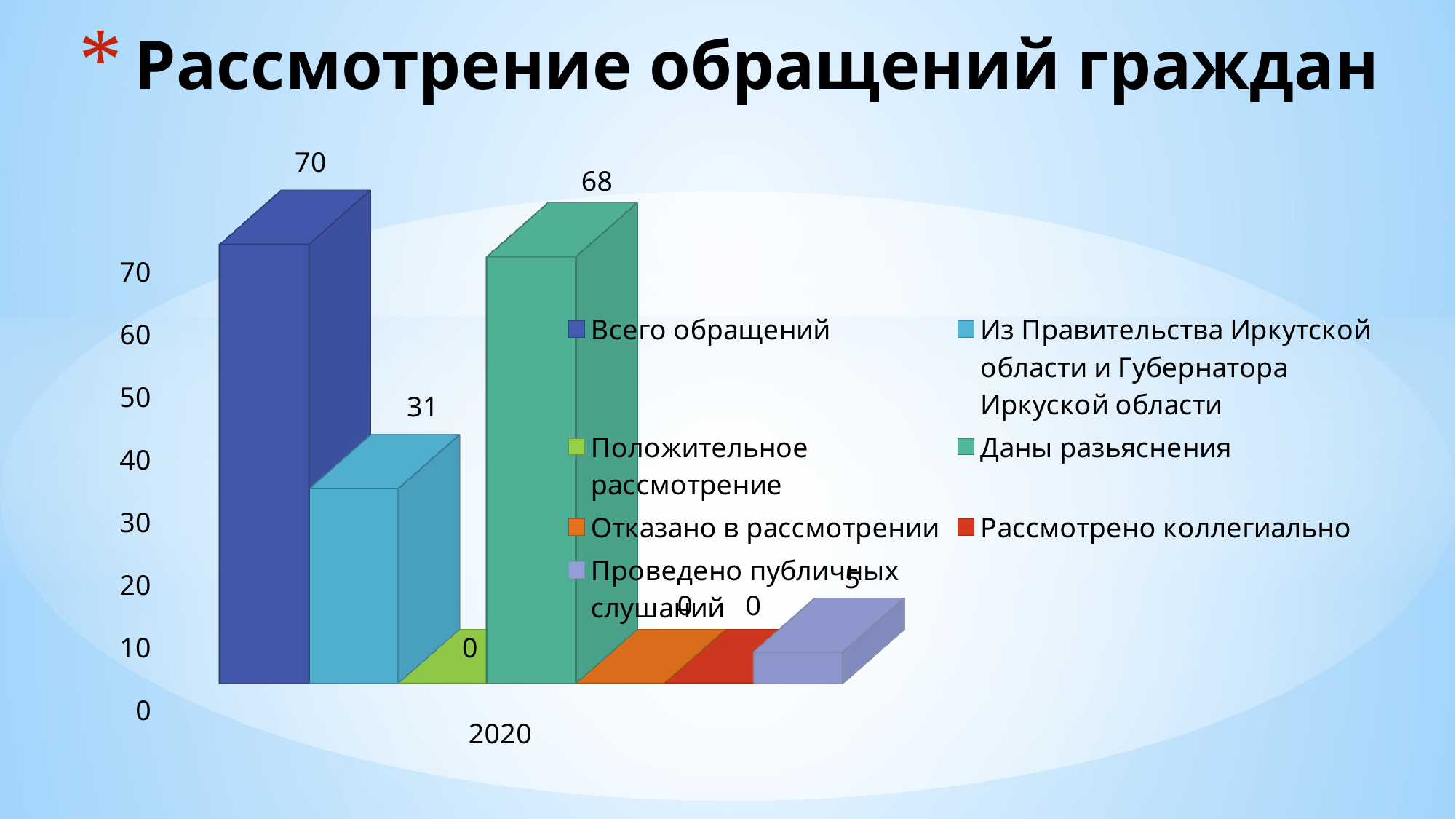
What is the title of the slide? Рассмотрение обращений граждан What kind of chart is shown on the slide? Bar chart What is the value for "Даны разъяснения" in 2020? 68 What is the value for "Положительное рассмотрение" in 2020? 0 Which series has the highest value in 2020? Всего обращений What is the difference between "Всего обращений" and "Даны разъяснения" in 2020? 2 How many series does the legend list? 7 What is the value for "Из Правительства Иркутской области и Губернатора Иркуской области" in 2020? 31 What is the value for "Проведено публичных слушаний" in 2020? 5 What is the difference between "Всего обращений" and "Из Правительства Иркутской области и Губернатора Иркуской области" in 2020? 39 Which is larger in 2020: "Из Правительства Иркутской области и Губернатора Иркуской области" or "Проведено публичных слушаний"? Из Правительства Иркутской области и Губернатора Иркуской области What is the value for "Всего обращений" in 2020? 70